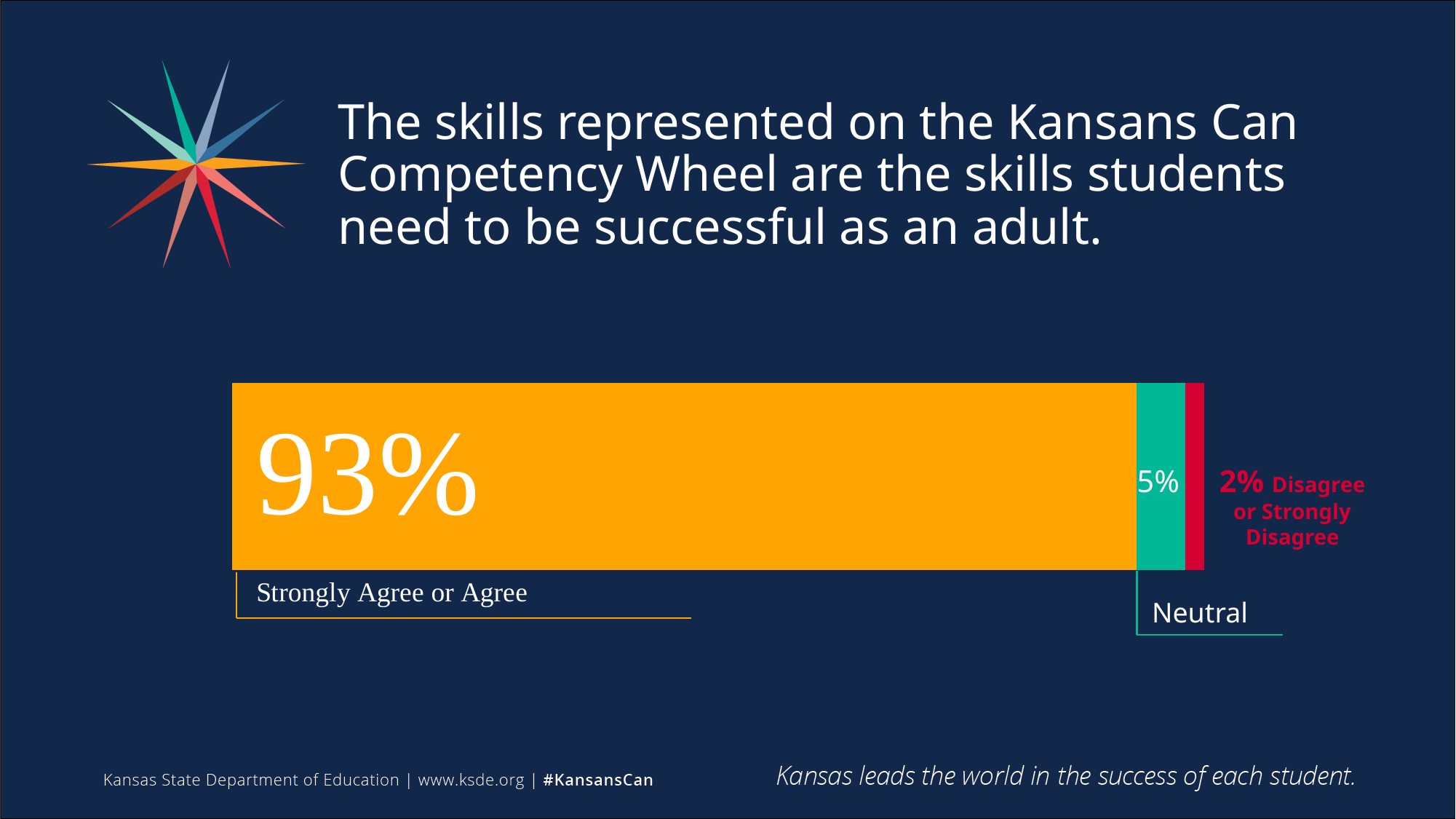
Which is larger, the Neutral share or the Disagree or Strongly Disagree share? Neutral What colour is the Neutral segment of the bar? Teal (green) What is the difference between the Neutral share and the Disagree or Strongly Disagree share? 3% How many response categories are shown in the bar? 3 What percentage of respondents answered Strongly Agree or Agree? 93% What percentage of respondents answered Neutral? 5% What percentage of respondents answered Disagree or Strongly Disagree? 2% What is the total of the three segments in the stacked bar? 100% Which response category has the largest share? Strongly Agree or Agree What is the difference between the Strongly Agree or Agree share and the Neutral share? 88% What kind of chart is shown on the slide? Bar chart Which response category has the smallest share? Disagree or Strongly Disagree